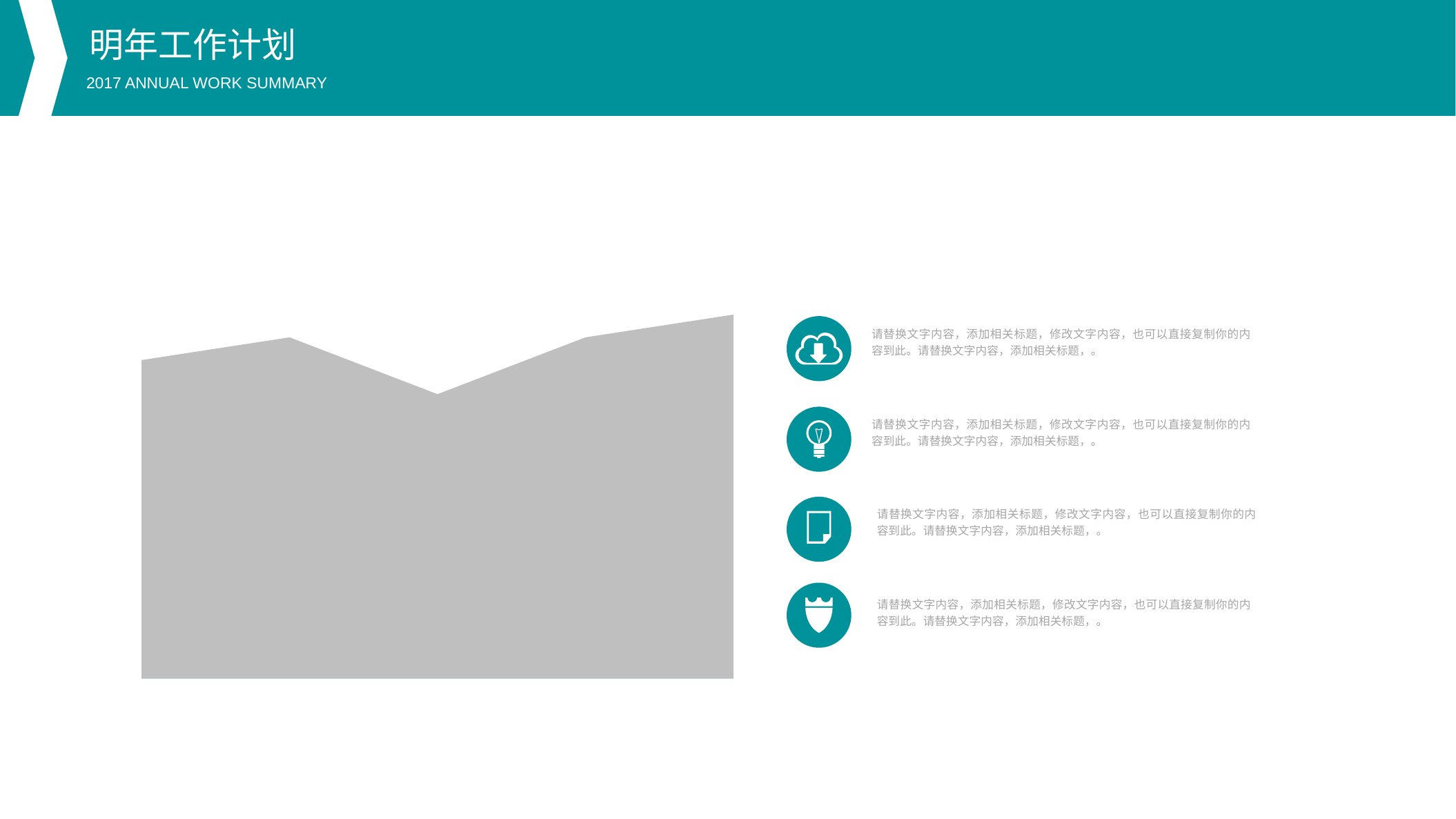
What colour is the filled area in the chart on the left? gray Does the area chart on the left show a legend? No In the area chart on the left, do the values rise or fall between the middle point and the last point? rise What kind of chart is shown on the left side of the slide? area chart In the area chart on the left, which point is the highest: the first, the middle, or the last? the last In the area chart on the left, which point is the lowest: the first, the middle, or the last? the middle In the area chart on the left, is the value at the right end higher or lower than the value at the left end? higher How many data points does the area chart on the left plot? 5